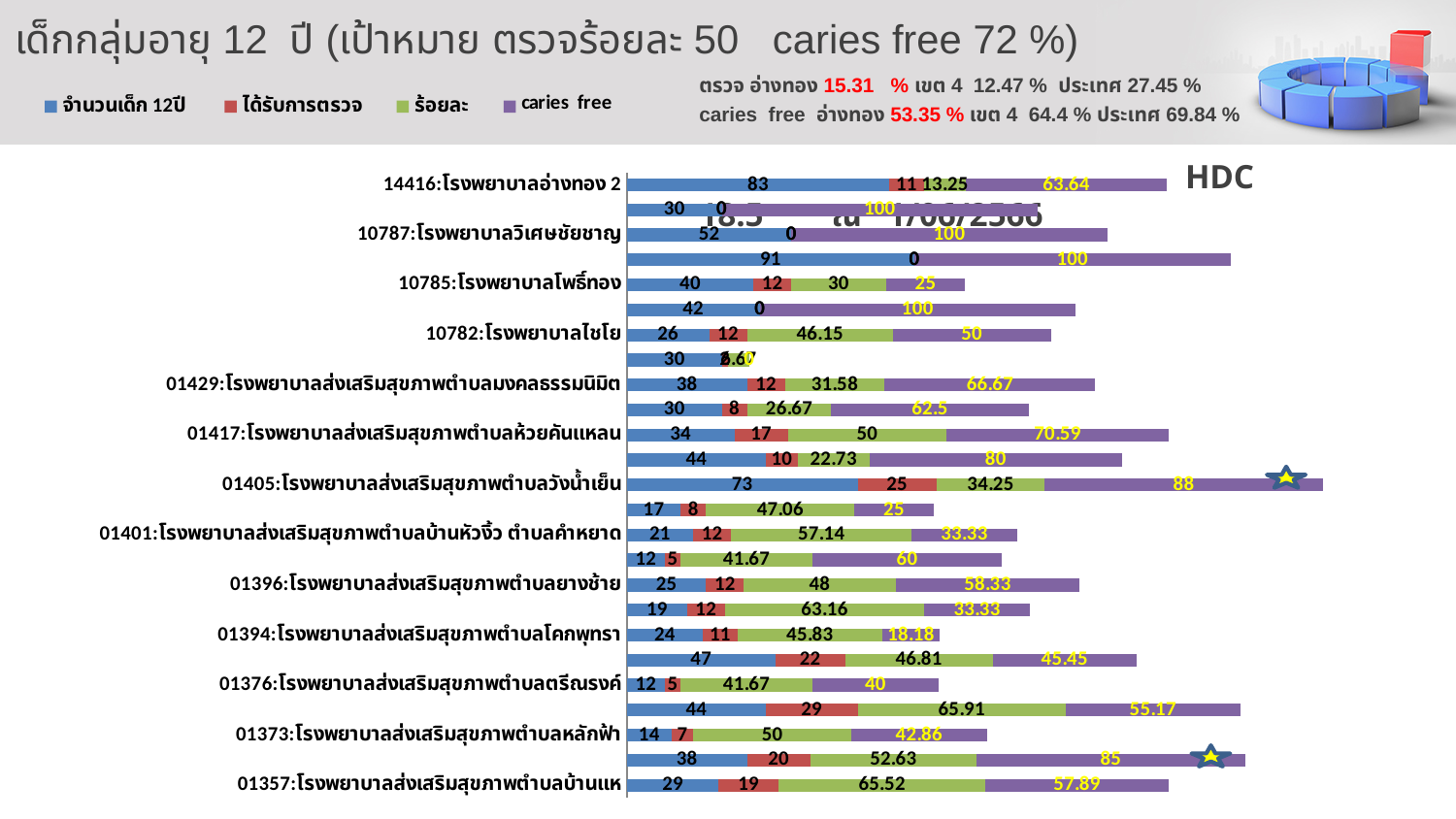
What is the title of the chart on the slide? เด็กกลุ่มอายุ 12 ปี (เป้าหมาย ตรวจร้อยละ 50 caries free 72 %) Which has the larger caries free value: 01405:โรงพยาบาลส่งเสริมสุขภาพตำบลวังน้ำเย็น or 01401:โรงพยาบาลส่งเสริมสุขภาพตำบลบ้านหัวงิ้ว ตำบลคำหยาด? 01405:โรงพยาบาลส่งเสริมสุขภาพตำบลวังน้ำเย็น Which has the larger ร้อยละ value: 10782:โรงพยาบาลไชโย or 01429:โรงพยาบาลส่งเสริมสุขภาพตำบลมงคลธรรมนิมิต? 10782:โรงพยาบาลไชโย What is the จำนวนเด็ก 12ปี value for 01405:โรงพยาบาลส่งเสริมสุขภาพตำบลวังน้ำเย็น? 73 What is the total of the stacked bar for 01376:โรงพยาบาลส่งเสริมสุขภาพตำบลตรีณรงค์? 98.67 How many series does the legend list? 4 What is the caries free value for 01394:โรงพยาบาลส่งเสริมสุขภาพตำบลโคกพุทรา? 18.18 What is the ได้รับการตรวจ value for 01417:โรงพยาบาลส่งเสริมสุขภาพตำบลห้วยคันแหลน? 17 What kind of chart is shown on the slide? bar chart What is the ร้อยละ value for 01357:โรงพยาบาลส่งเสริมสุขภาพตำบลบ้านแห? 65.52 What is the caries free value for 14416:โรงพยาบาลอ่างทอง 2? 63.64 What is the difference between the จำนวนเด็ก 12ปี value and the ได้รับการตรวจ value for 10785:โรงพยาบาลโพธิ์ทอง? 28